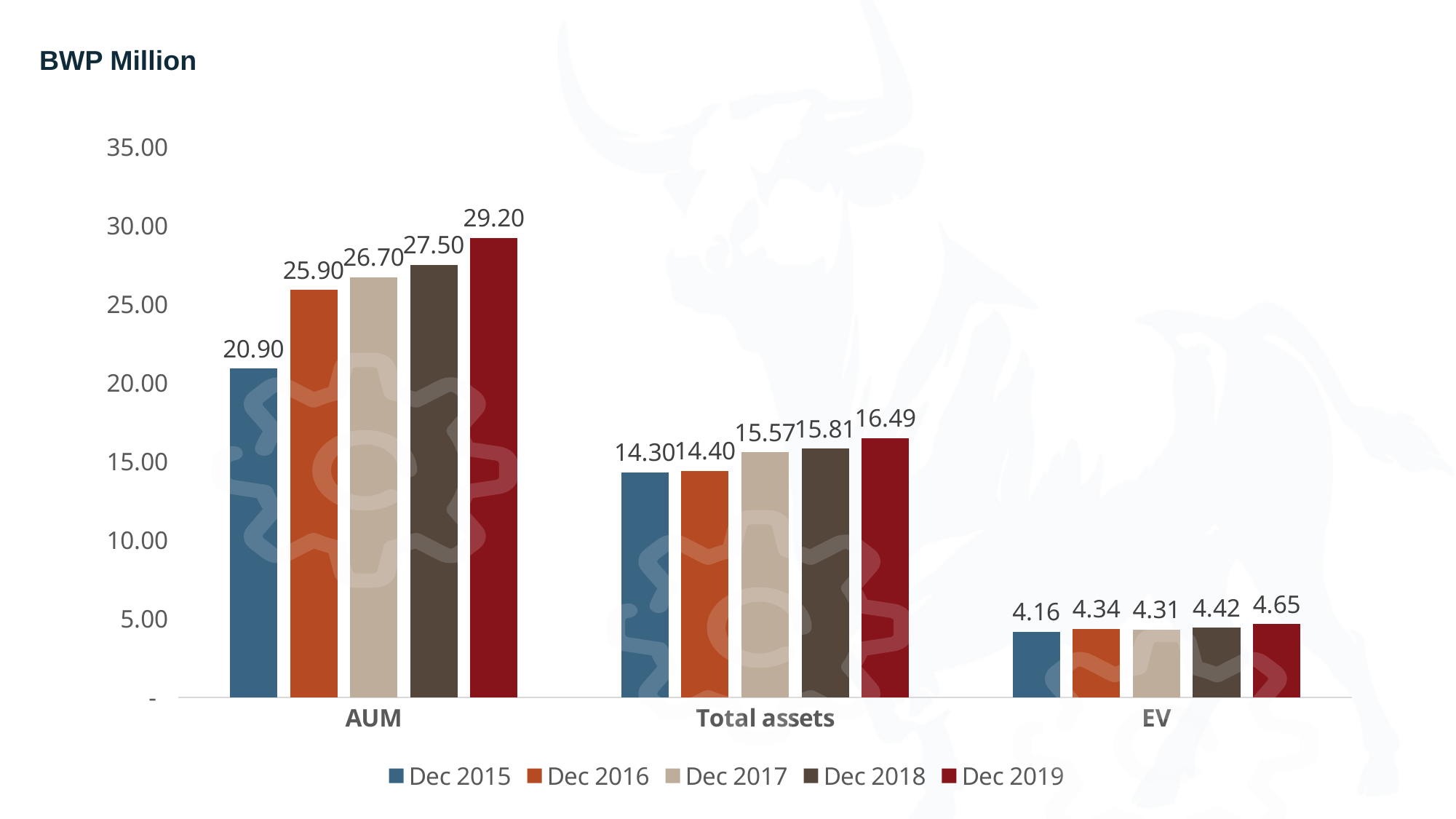
Which is larger, the EV value for Dec 2016 or for Dec 2017? Dec 2016 What is the EV value for Dec 2015? 4.16 Which period has the highest AUM value? Dec 2019 Is the Total assets value for Dec 2019 greater or less than 15.00? greater What unit is stated in the chart's title? BWP Million How many series does the legend list? 5 Which period has the lowest Total assets value? Dec 2015 What is the difference between the AUM values for Dec 2019 and Dec 2015? 8.30 What is the AUM value for Dec 2019? 29.20 What kind of chart is shown on the slide? bar chart How many categories are shown on the x axis? 3 What is the Total assets value for Dec 2017? 15.57